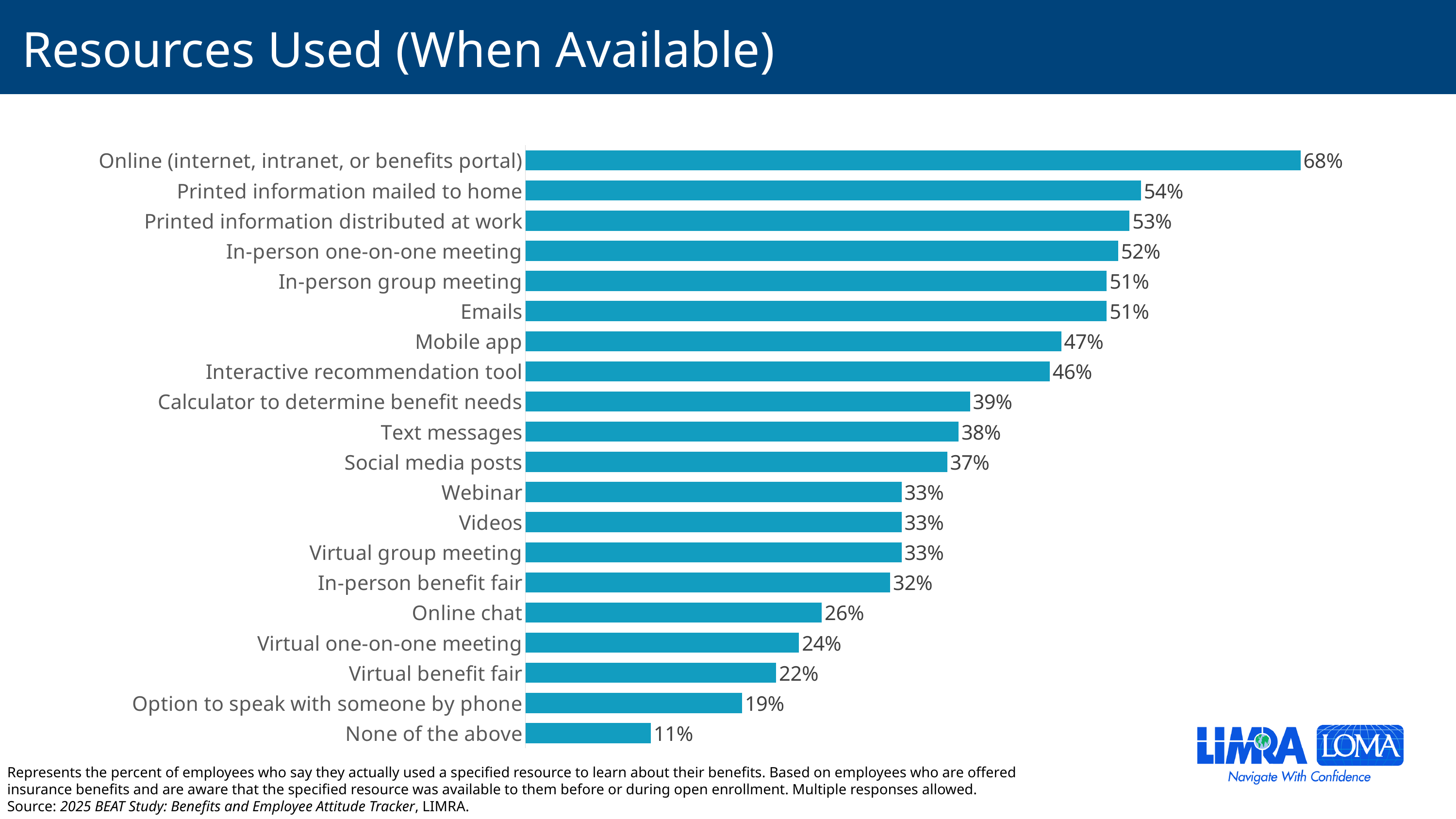
Which category has the lowest value? None of the above Which is larger, Text messages or Online chat? Text messages What is the difference between Online (internet, intranet, or benefits portal) and None of the above? 57% Which is larger, Calculator to determine benefit needs or Webinar? Calculator to determine benefit needs Which resource has the highest value? Online (internet, intranet, or benefits portal) What is the title of the slide? Resources Used (When Available) What is the value for Option to speak with someone by phone? 19% What is the difference between Printed information mailed to home and Virtual benefit fair? 32% How many categories are shown in the chart? 20 What kind of chart is shown on the slide? Bar chart What is the value for Mobile app? 47% What percentage of employees used Online (internet, intranet, or benefits portal)? 68%